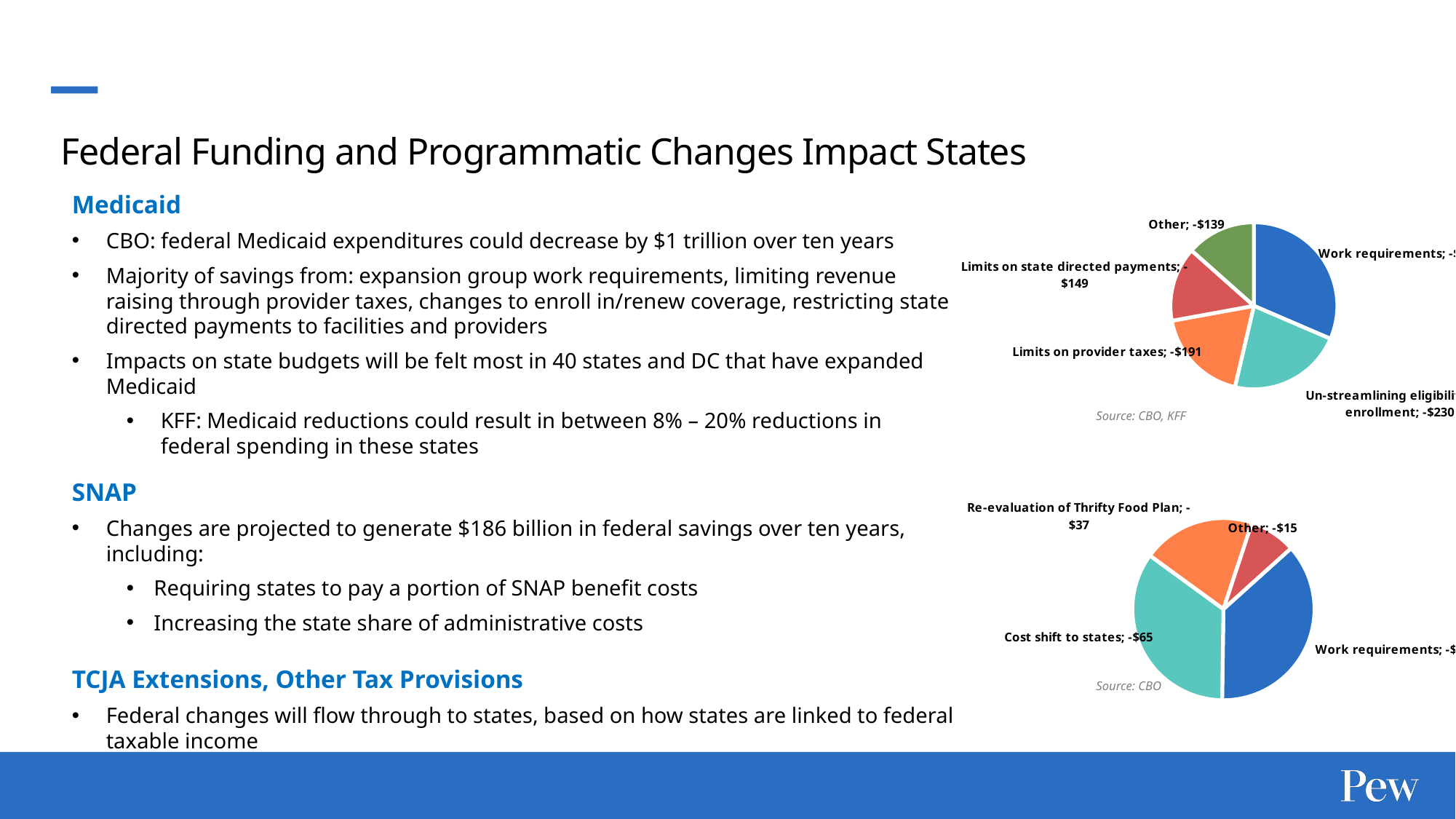
How many slices does the top pie chart have? 5 On the bottom pie chart, what is the value shown for Re-evaluation of Thrifty Food Plan? -$37 On the top pie chart, which slice is larger: Limits on provider taxes or Other? Limits on provider taxes What kind of chart is the top chart on the slide? Pie chart On the top pie chart, what is the value shown for Limits on state directed payments? -$149 On the top pie chart, what is the difference between the values for Limits on provider taxes and Limits on state directed payments? $42 How many slices does the bottom pie chart have? 4 On the bottom pie chart, what is the value shown for Other? -$15 On the top pie chart, what is the value shown for Other? -$139 On the top pie chart, what is the value shown for Limits on provider taxes? -$191 On the bottom pie chart, what is the value shown for Cost shift to states? -$65 On the bottom pie chart, which slice is the largest? Work requirements